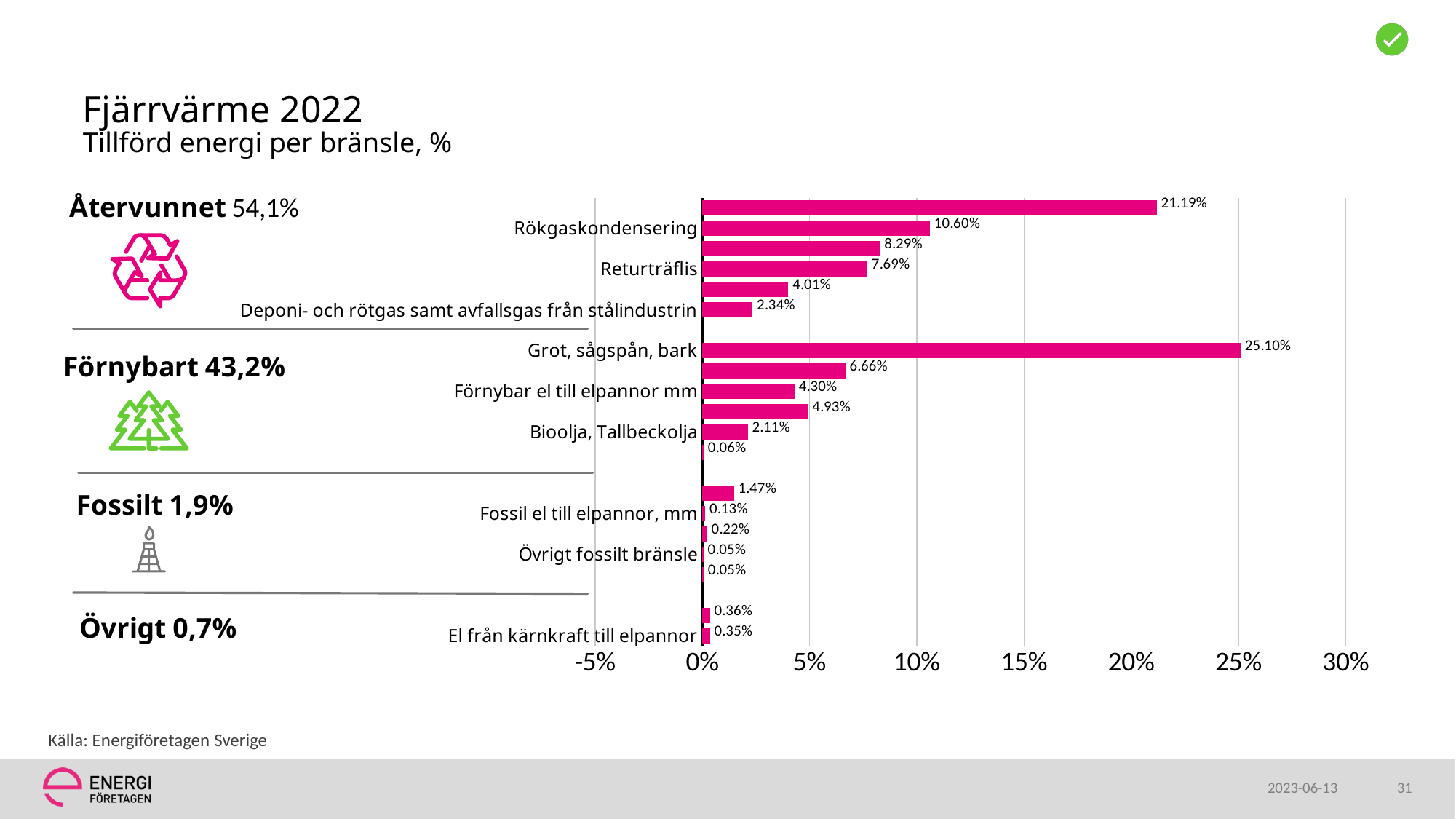
Which is larger, Returträflis or Förnybar el till elpannor mm? Returträflis What is the value for Rökgaskondensering? 10.60% Is the value for Grot, sågspån, bark greater or less than 20%? greater What is the difference between Rökgaskondensering and Returträflis? 2.91% What is the value for Returträflis? 7.69% What kind of chart is shown on the slide? Bar chart What is the value for Grot, sågspån, bark? 25.10% What is the value for Deponi- och rötgas samt avfallsgas från stålindustrin? 2.34% What is the value for Förnybar el till elpannor mm? 4.30% What is the difference between Förnybar el till elpannor mm and Bioolja, Tallbeckolja? 2.19% Which labelled category has the highest value? Grot, sågspån, bark What is the value for El från kärnkraft till elpannor? 0.35%